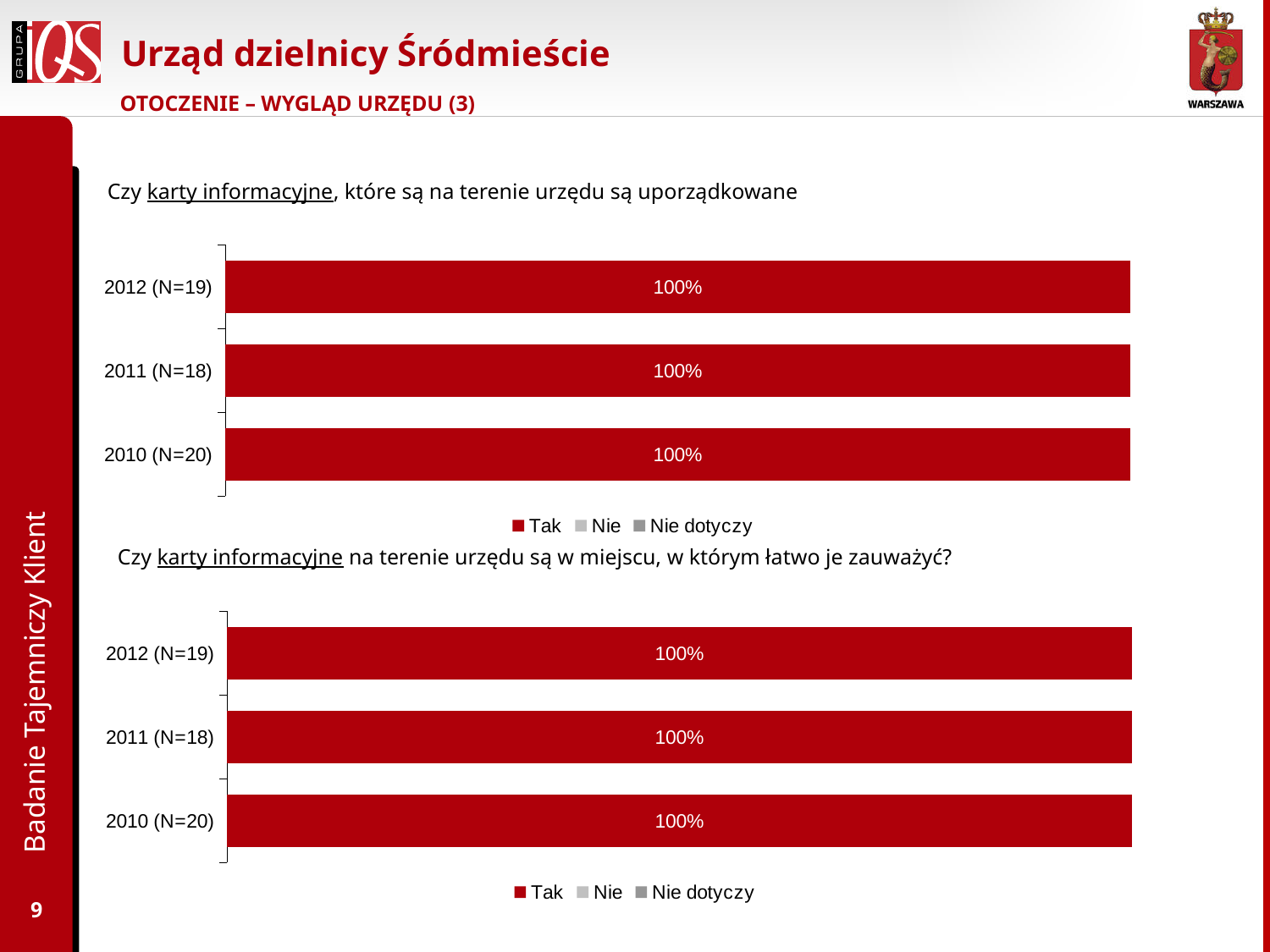
In the bottom chart ("Czy karty informacyjne na terenie urzędu są w miejscu, w którym łatwo je zauważyć?"), what is the value of the Tak segment for 2011 (N=18)? 100% How many categories (years) are shown in the top chart? 3 In the top chart ("Czy karty informacyjne, które są na terenie urzędu są uporządkowane"), what is the value of the Tak segment for 2012 (N=19)? 100% In the bottom chart, what is the difference between the Tak values for 2012 (N=19) and 2010 (N=20)? 0% In the top chart, what is the total of the stacked bar for 2011 (N=18)? 100% How many series does the legend of the top chart list? 3 What kind of chart is the bottom chart? Bar chart In the top chart, what is the value of the Tak segment for 2010 (N=20)? 100% In the top chart, what colour are the Tak bars? Red In the bottom chart, what is the value of the Tak segment for 2012 (N=19)? 100% What are the legend entries of the bottom chart? Tak, Nie, Nie dotyczy How many categories (years) are shown in the bottom chart? 3